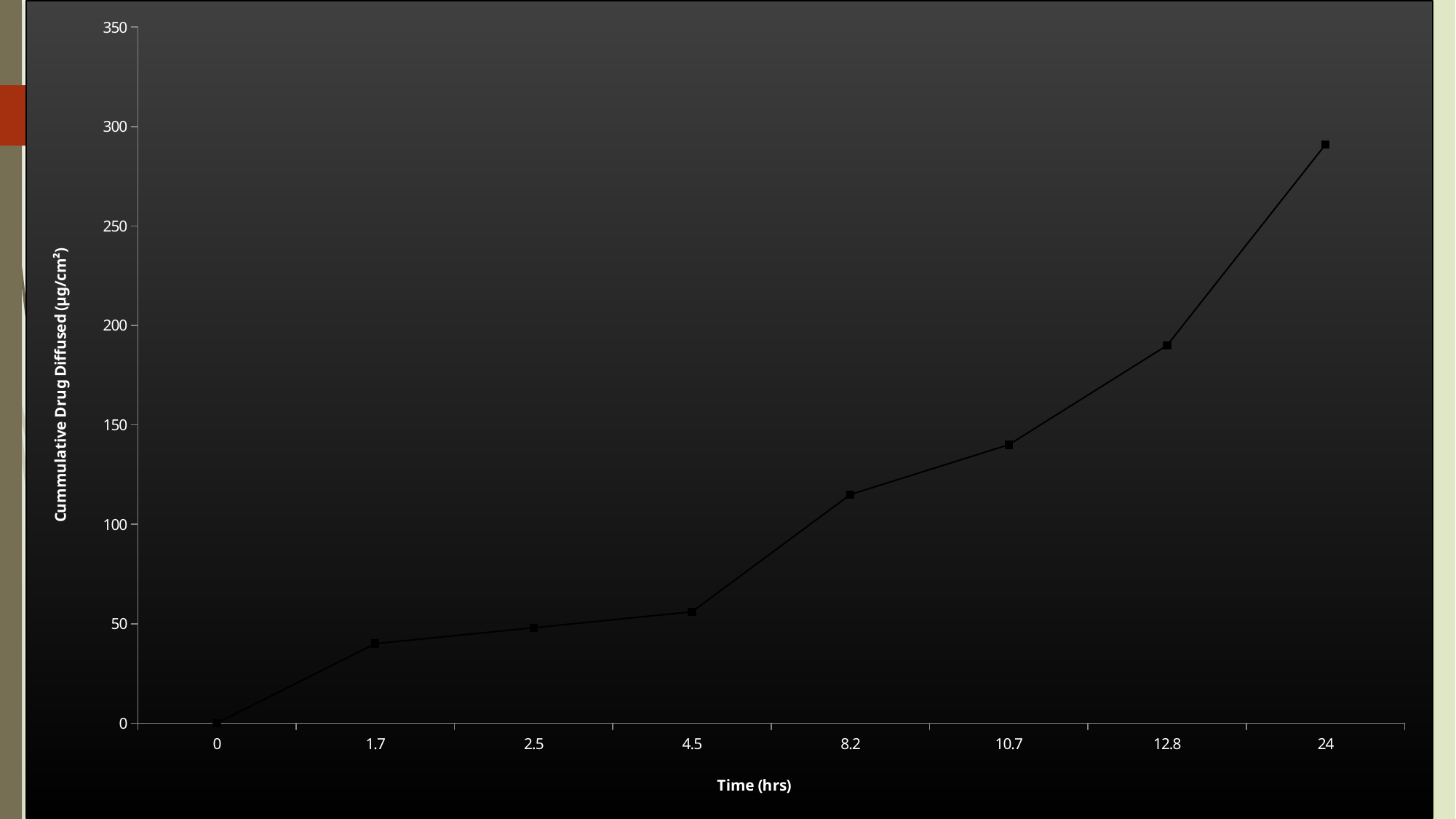
How many time points are plotted on the chart? 8 Is the value at 4.5 hrs greater or less than 100? less Which is larger, the value at 10.7 hrs or the value at 12.8 hrs? 12.8 hrs What is the label of the x axis? Time (hrs) Is the value at 24 hrs greater or less than 250? greater What kind of chart is shown on the slide? line chart Is the value at 8.2 hrs greater or less than 100? greater What is the cumulative drug diffused at time 0 hrs? 0 At which time point is the cumulative drug diffused lowest? 0 At which time point is the cumulative drug diffused highest? 24 Do the values rise or fall as time increases along the x axis? rise